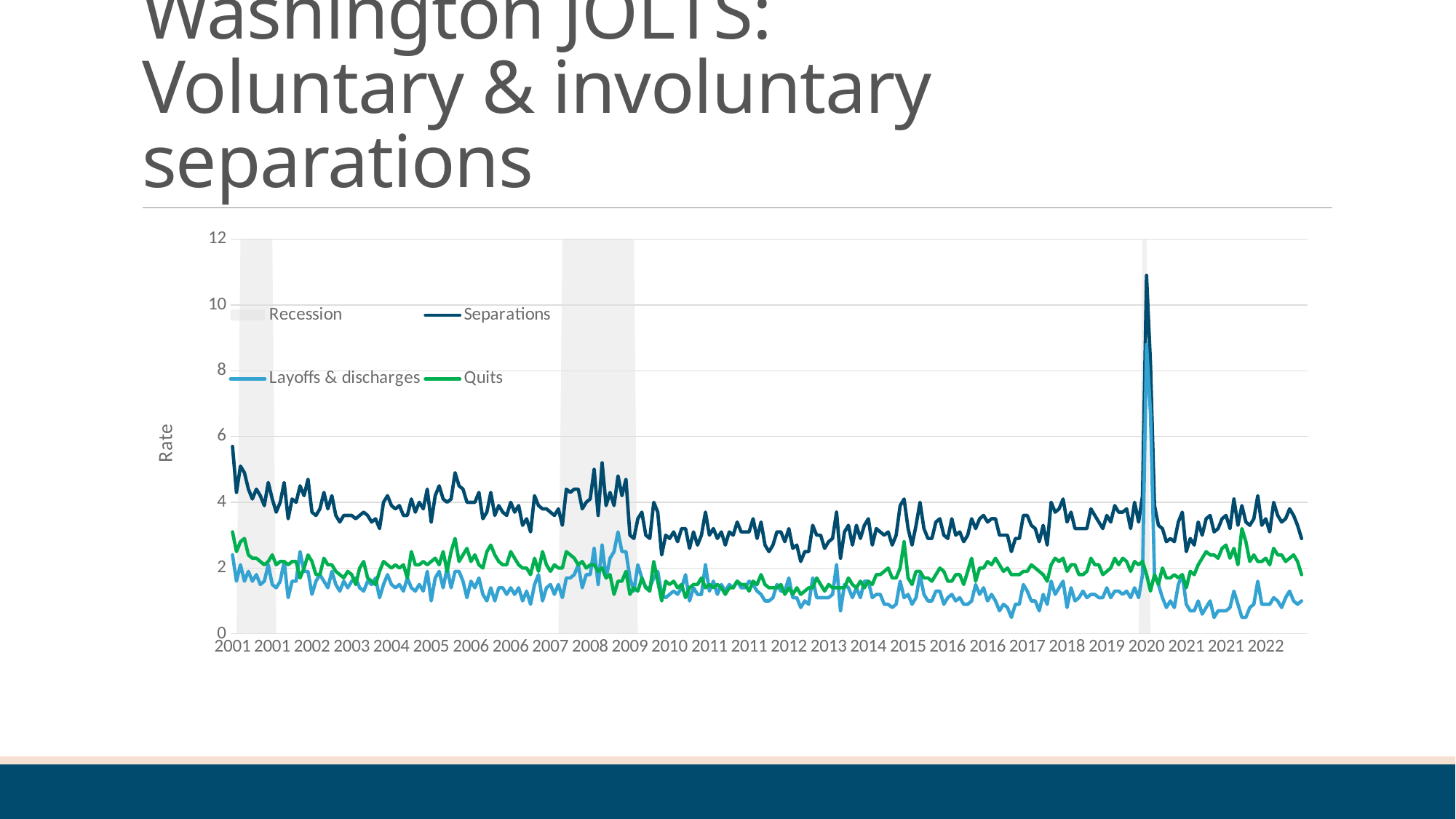
Which series reaches the highest value on the chart? Separations Is the value of the Separations series at the start of 2001 greater or less than 4? greater What is the label on the vertical axis of the chart? Rate How many entries does the chart legend list? 4 Does the Quits series rise or fall overall from 2010 to 2022? rise What does the grey shading in the chart represent, according to the legend? Recession Is the value of the Quits series at the end of 2022 greater or less than 4? less What kind of chart is shown on the slide? line chart Is the peak value of the Layoffs & discharges series in 2020 greater or less than 8? greater Which series is higher throughout the chart, Separations or Quits? Separations Does the Layoffs & discharges series rise or fall overall from 2001 to 2022? fall